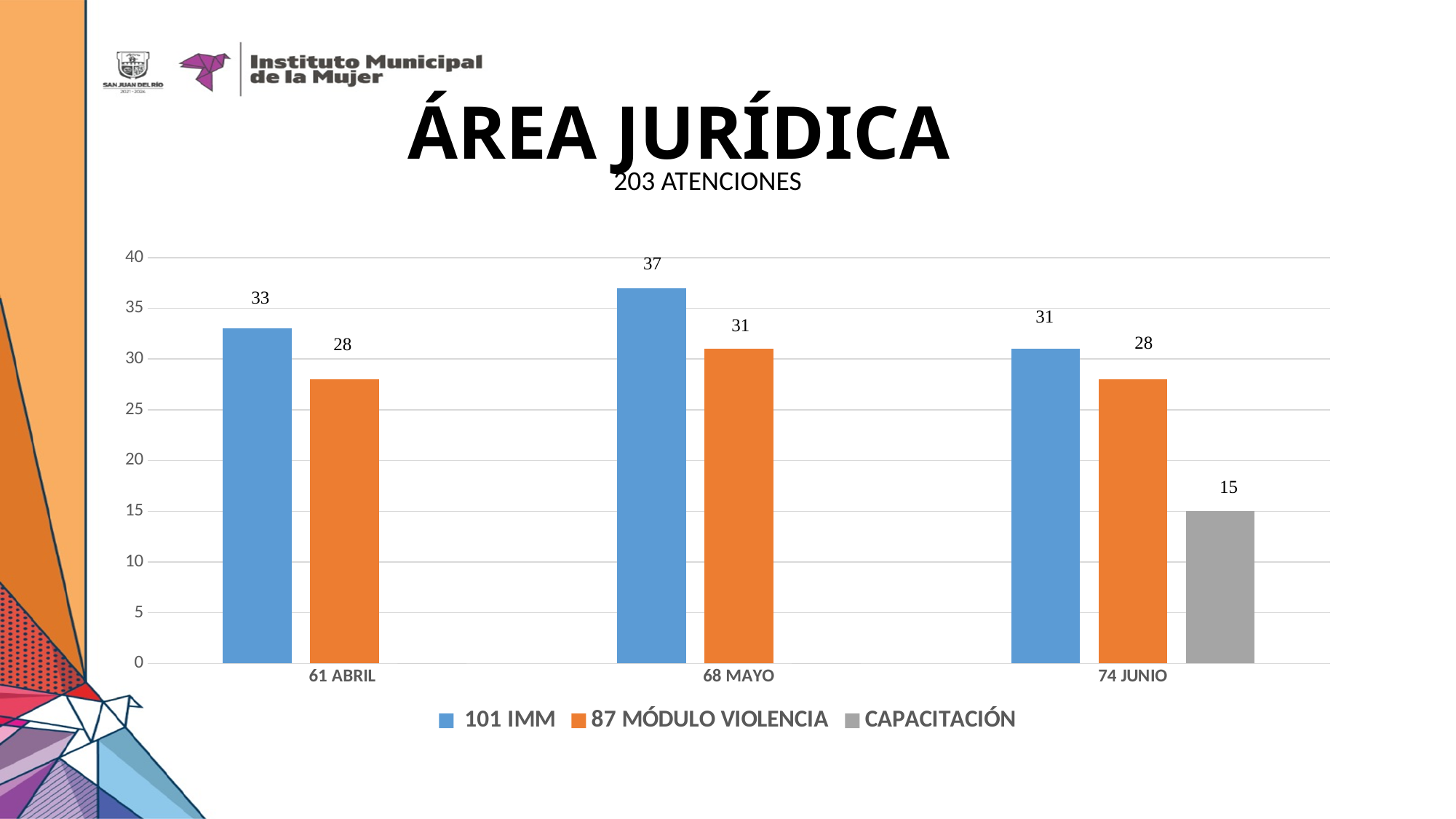
In which month is the 101 IMM value highest? 68 MAYO What is the value for CAPACITACIÓN in 74 JUNIO? 15 What is the value for 101 IMM in 68 MAYO? 37 Which is larger in 74 JUNIO: 101 IMM or 87 MÓDULO VIOLENCIA? 101 IMM What kind of chart is shown on the slide? Bar chart What is the value for 87 MÓDULO VIOLENCIA in 61 ABRIL? 28 How many months are shown on the x axis? 3 In which month is the 101 IMM value lowest? 74 JUNIO Is the value for 87 MÓDULO VIOLENCIA in 68 MAYO greater or less than 30? greater How many series does the legend list? 3 What is the difference between the 101 IMM and 87 MÓDULO VIOLENCIA values in 61 ABRIL? 5 What is the title of the slide above the chart? ÁREA JURÍDICA